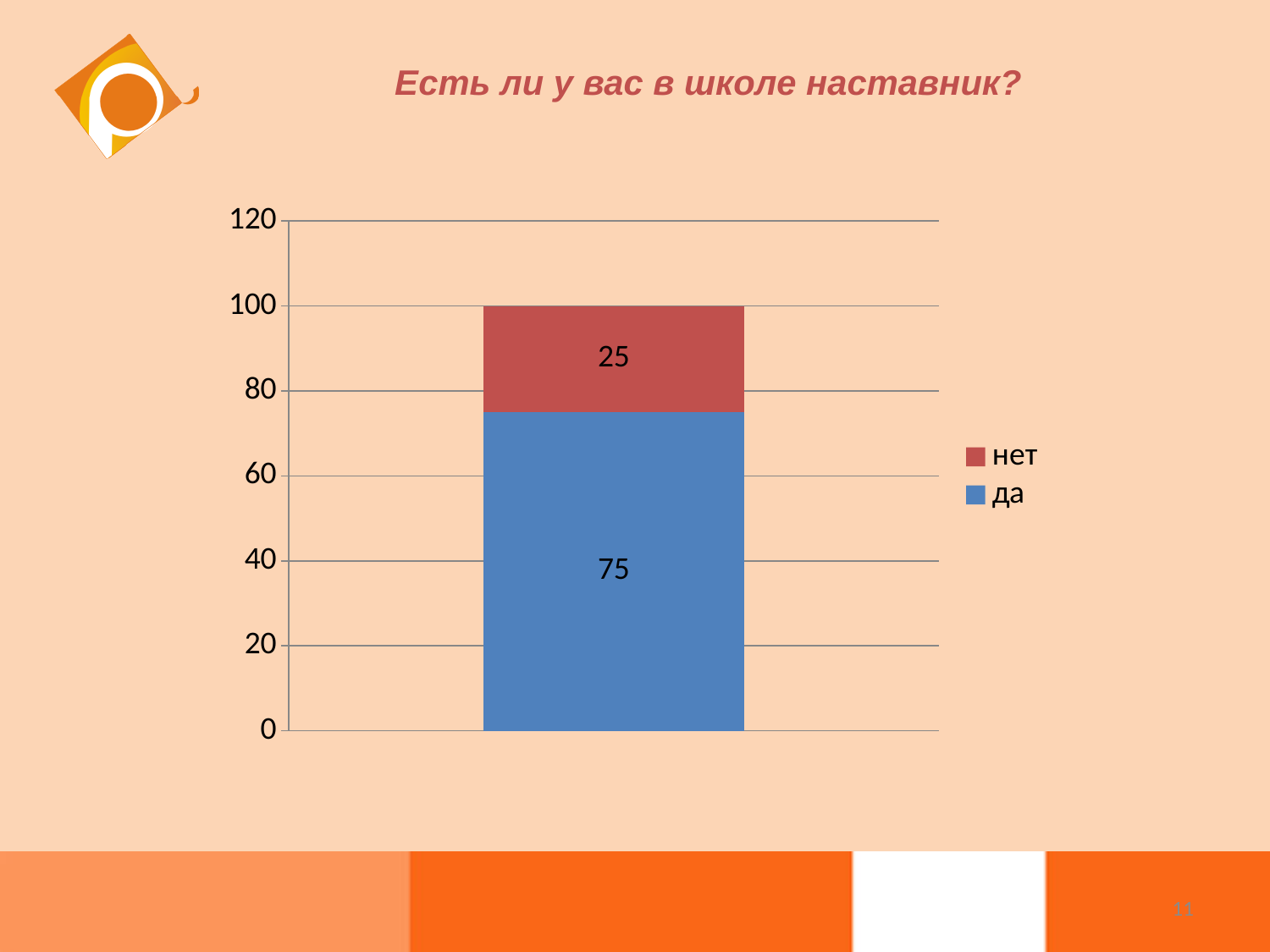
Which series has the larger value, "да" or "нет"? да What colour represents the "да" series in the chart? Blue What is the value for "да" in the chart? 75 Is the value for "нет" greater or less than 40? less Is the value for "да" greater or less than 60? greater What kind of chart is shown on the slide? Stacked bar chart What is the total of the stacked bar? 100 What is the value for "нет" in the chart? 25 What is the title of the chart on the slide? Есть ли у вас в школе наставник? Which series has the smallest value in the chart? нет How many series does the legend list? 2 What is the difference between the values for "да" and "нет"? 50